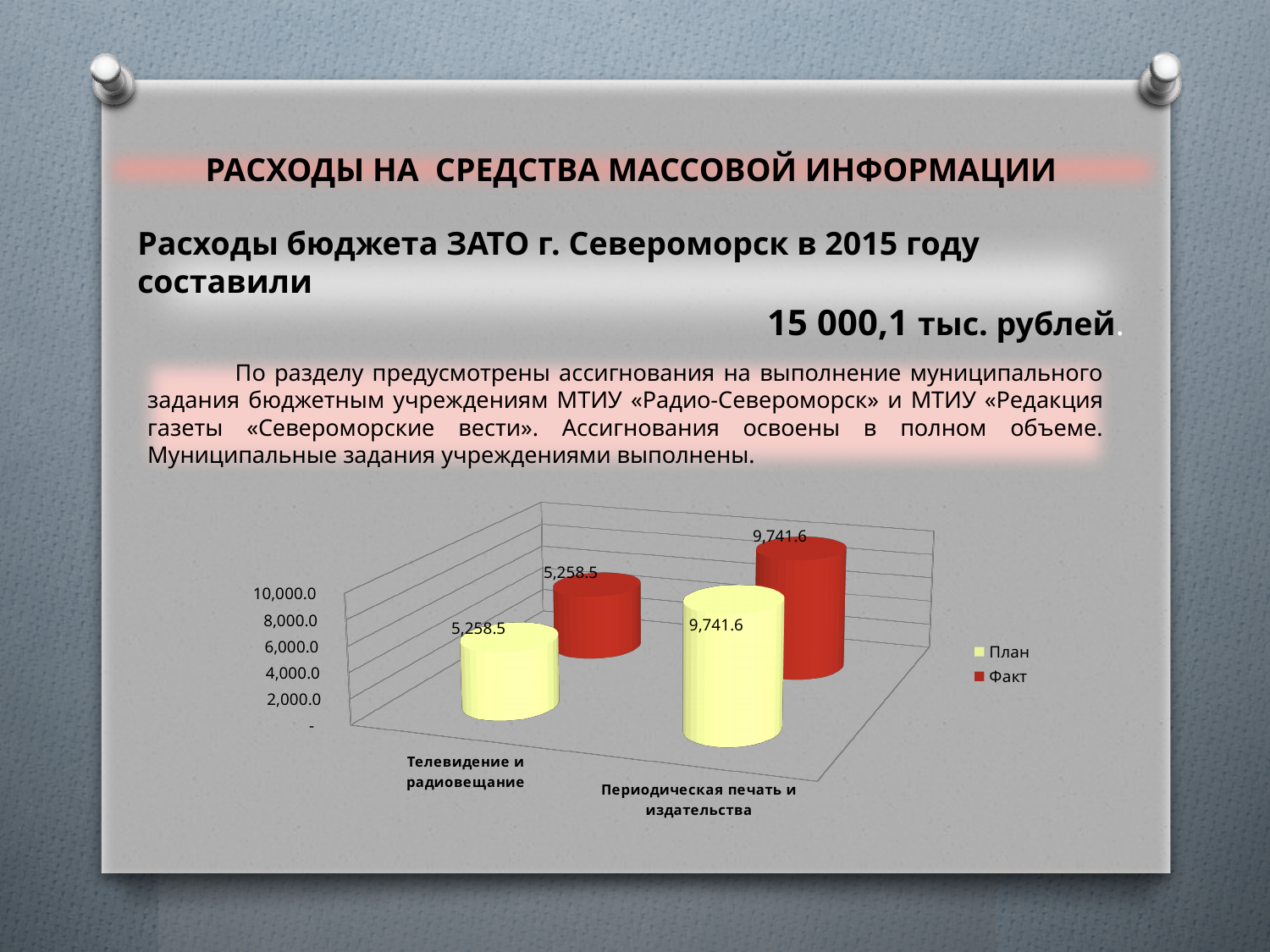
What is the Факт value for Телевидение и радиовещание? 5,258.5 What colour represents the Факт series in the chart? red Which is larger: the Факт value for Периодическая печать и издательства or the Факт value for Телевидение и радиовещание? Периодическая печать и издательства Which category has the lowest Факт value? Телевидение и радиовещание Is the План value for Периодическая печать и издательства greater or less than 8,000.0? greater What is the План value for Телевидение и радиовещание? 5,258.5 What is the Факт value for Периодическая печать и издательства? 9,741.6 What is the difference between the План values for Периодическая печать и издательства and Телевидение и радиовещание? 4,483.1 Which category has the highest План value? Периодическая печать и издательства How many series does the chart legend list? 2 What kind of chart is shown on the slide? bar chart How many categories are shown on the x axis of the chart? 2